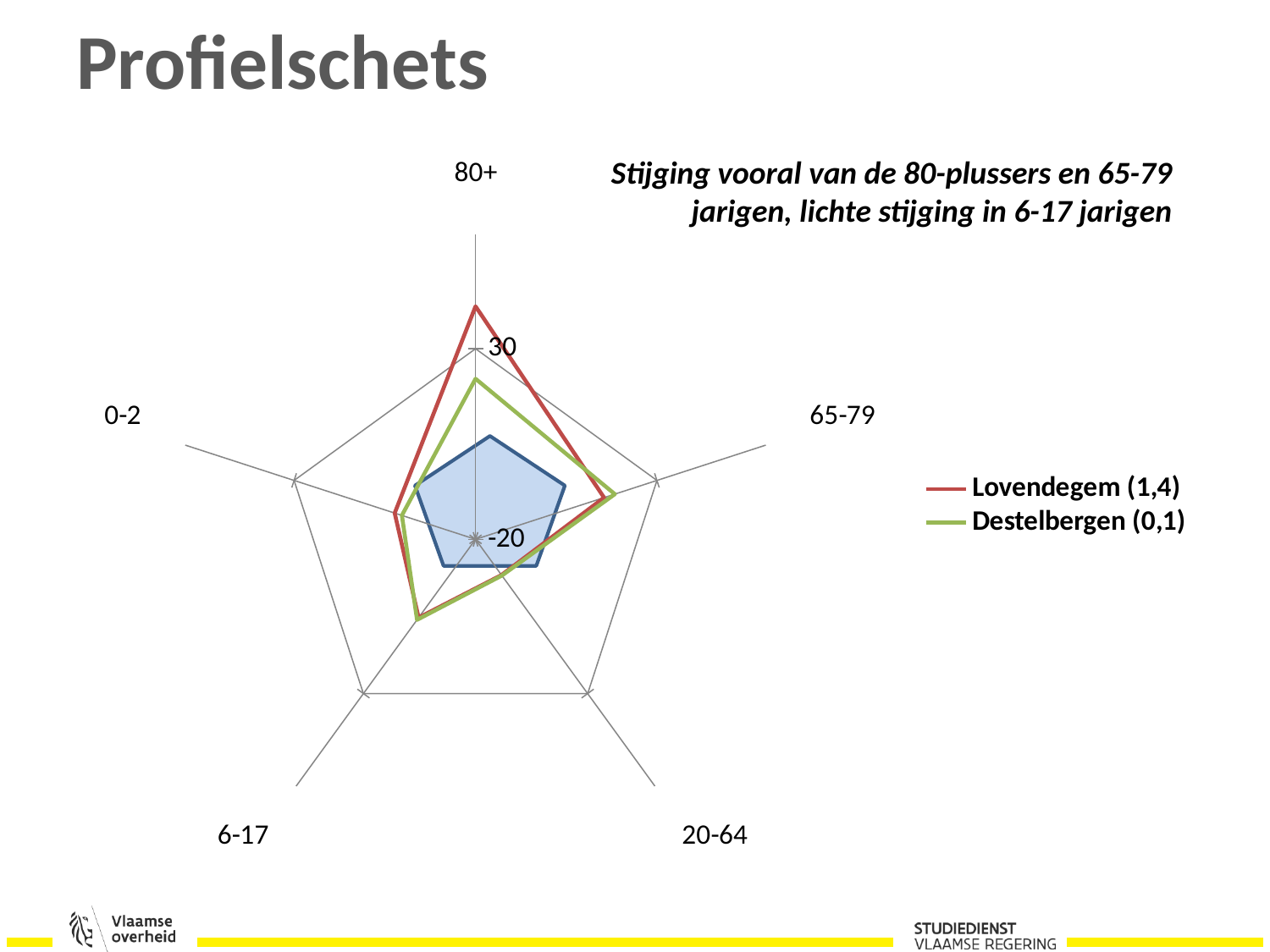
For which age category does the Destelbergen (0,1) series have its lowest value? 20-64 Which series is drawn in green on the radar chart? Destelbergen (0,1) How many series does the chart legend list? 2 For which age category does the Lovendegem (1,4) series reach its highest value? 80+ What kind of chart is shown on the slide? radar chart Which series is drawn in red on the radar chart? Lovendegem (1,4) Is the value for Lovendegem (1,4) in the 20-64 category greater or less than 30? less For which age category does the Lovendegem (1,4) series have its lowest value? 20-64 How many age categories are plotted on the radar chart? 5 Is the value for Lovendegem (1,4) in the 80+ category greater or less than 30? greater In the 80+ category, which series has the larger value, Lovendegem (1,4) or Destelbergen (0,1)? Lovendegem (1,4) Is the value for Destelbergen (0,1) in the 20-64 category greater or less than 30? less